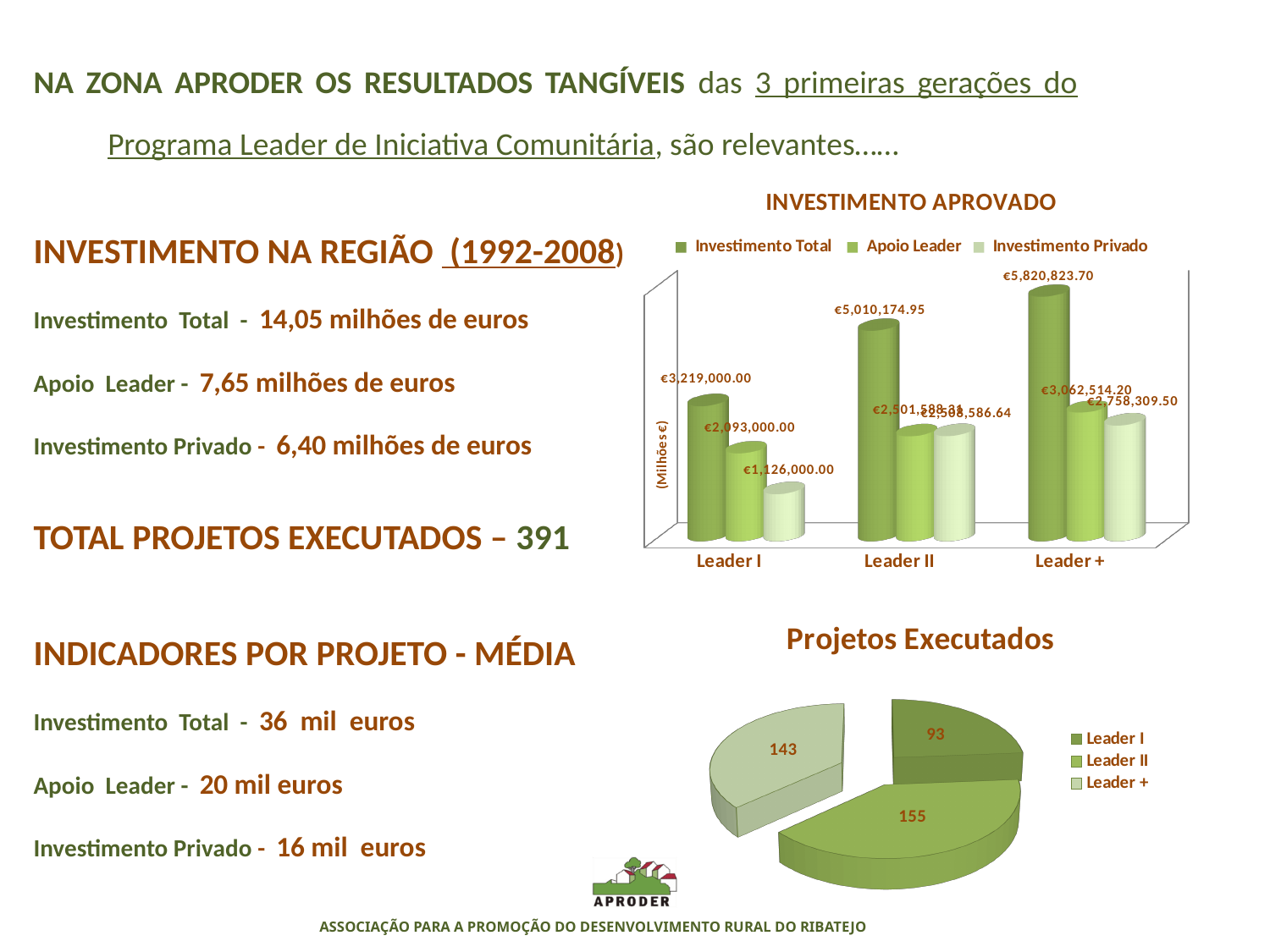
In the INVESTIMENTO APROVADO chart, does the Investimento Total rise or fall from Leader I to Leader +? rise What kind of chart is the Projetos Executados chart? pie chart In the INVESTIMENTO APROVADO chart, how many series does the legend list? 3 In the Projetos Executados chart, how many more projects were executed under Leader + than under Leader I? 50 In the INVESTIMENTO APROVADO chart, what is the Apoio Leader value for Leader +? €3,062,514.20 In the INVESTIMENTO APROVADO chart, what is the Investimento Total value for Leader +? €5,820,823.70 In the INVESTIMENTO APROVADO chart, which category has the highest Investimento Total? Leader + In the INVESTIMENTO APROVADO chart, what is the Investimento Privado value for Leader I? €1,126,000.00 In the Projetos Executados chart, how many projects were executed under Leader II? 155 In the INVESTIMENTO APROVADO chart, which category has the lowest Investimento Privado? Leader I In the INVESTIMENTO APROVADO chart, what is the difference between the Investimento Total for Leader I and the Apoio Leader for Leader I? €1,126,000.00 In the Projetos Executados chart, which generation has the fewest executed projects? Leader I